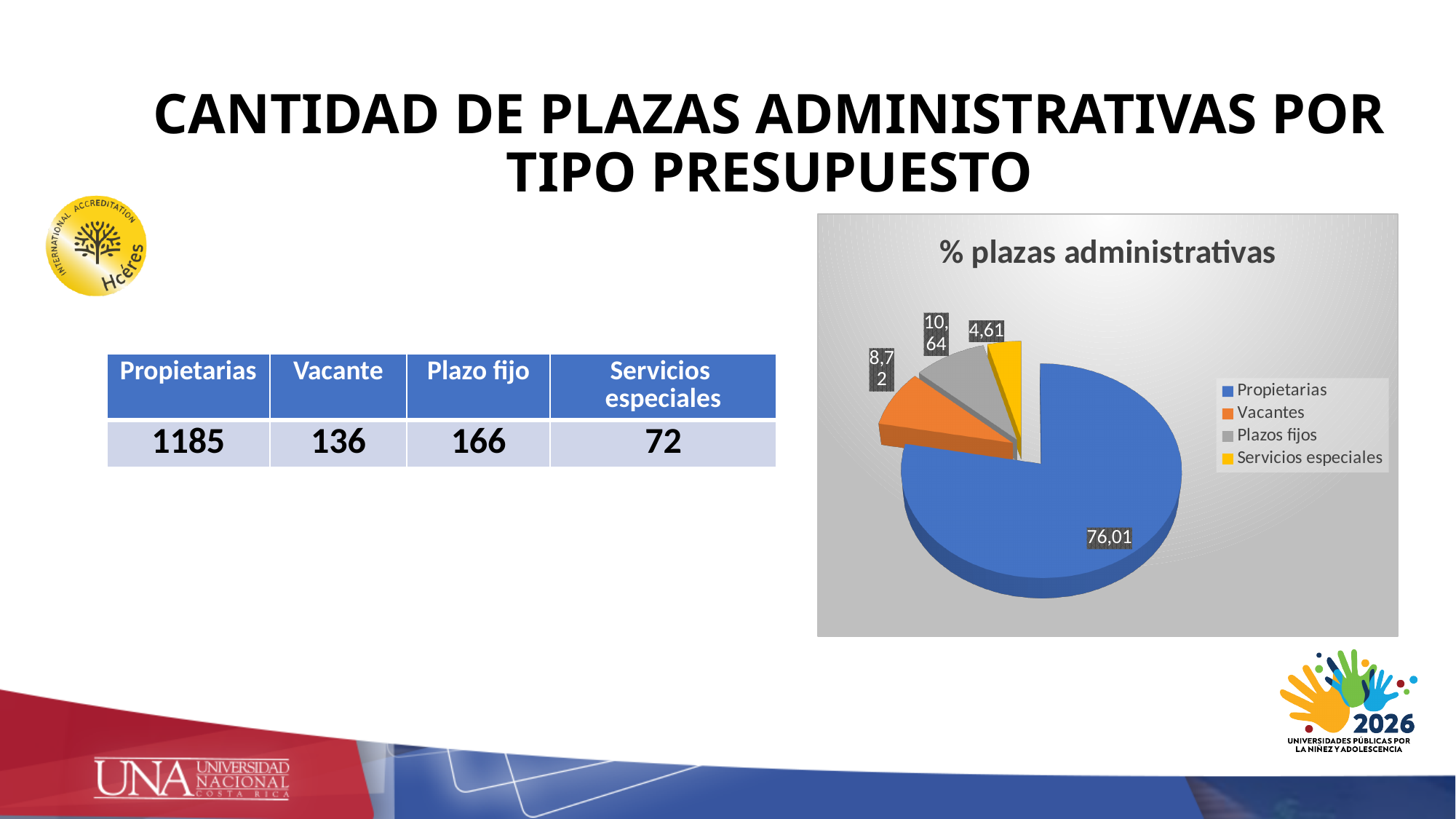
Which category has the largest slice of the pie chart? Propietarias What colour is the Servicios especiales slice in the pie chart? yellow What value is shown for Servicios especiales in the pie chart? 4,61 How many entries does the chart legend list? 4 Which slice is larger, Vacantes or Plazos fijos? Plazos fijos Which category has the smallest slice of the pie chart? Servicios especiales What is the title of the chart? % plazas administrativas What type of chart is shown on the slide? pie chart How many slices does the pie chart have? 4 What value is shown for Propietarias in the pie chart? 76,01 What value is shown for Plazos fijos in the pie chart? 10,64 What value is shown for Vacantes in the pie chart? 8,72